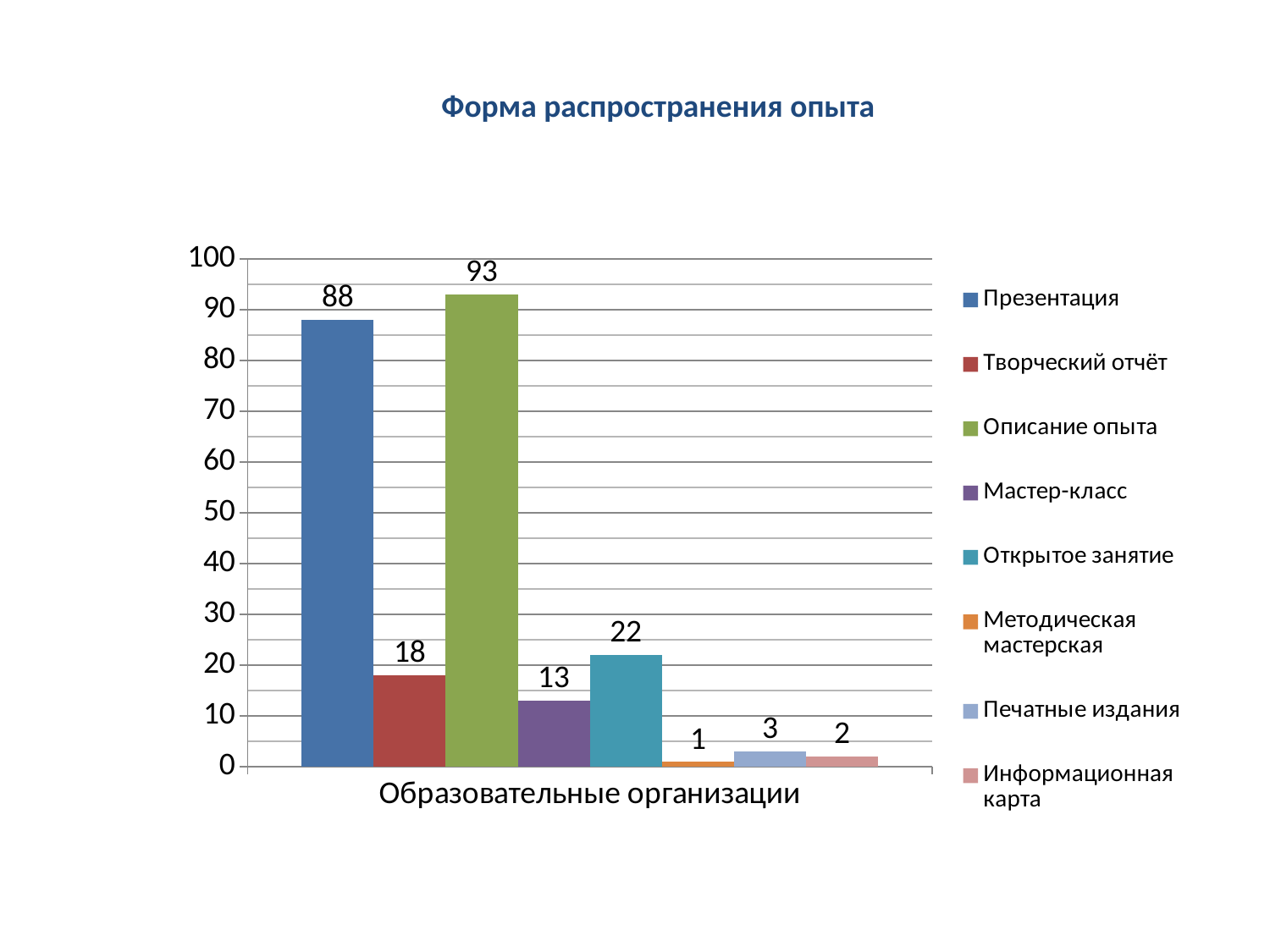
What is the value for Описание опыта? 93 How many series does the legend list? 8 What kind of chart is shown on the slide? Bar chart What is the value for Открытое занятие? 22 Which is larger, the value for Творческий отчёт or the value for Мастер-класс? Творческий отчёт What is the category label on the x axis? Образовательные организации Which series has the highest value? Описание опыта Which series has the lowest value? Методическая мастерская What is the difference between the values for Описание опыта and Презентация? 5 What is the value for Методическая мастерская? 1 What is the title of the chart? Форма распространения опыта What is the value for Презентация? 88